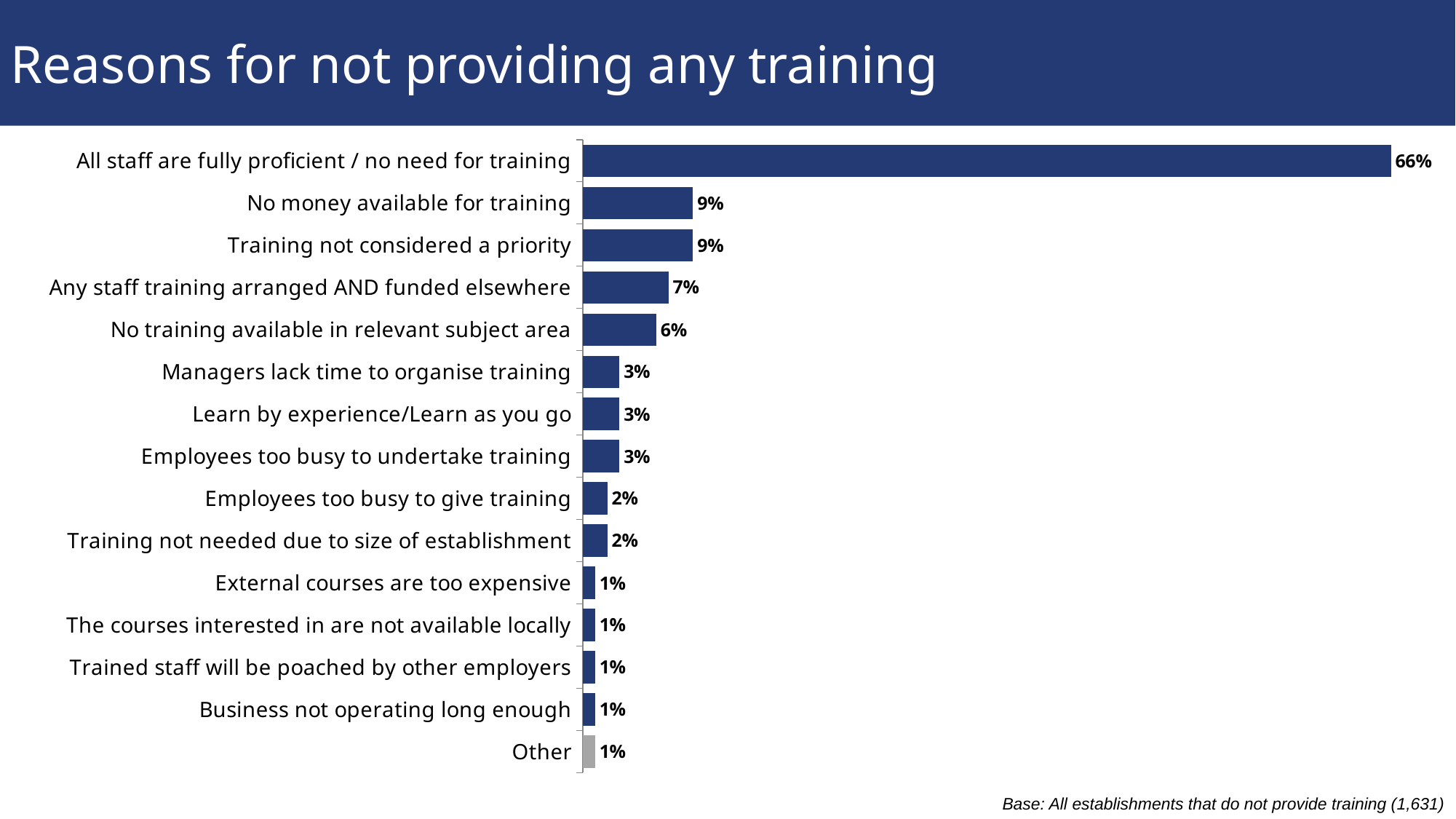
Which reason has the highest percentage? All staff are fully proficient / no need for training How many reasons (categories) are shown in the chart? 15 What is the value for 'Training not needed due to size of establishment'? 2% What percentage of establishments gave 'All staff are fully proficient / no need for training' as a reason for not providing training? 66% What type of chart is shown on the slide? Bar chart What is the title of the slide? Reasons for not providing any training What is the difference between 'All staff are fully proficient / no need for training' and 'No money available for training'? 57% What is the difference between 'Any staff training arranged AND funded elsewhere' and 'Managers lack time to organise training'? 4% What is the value for 'Any staff training arranged AND funded elsewhere'? 7% Which category's bar is coloured grey rather than dark blue? Other Which is larger: 'No training available in relevant subject area' or 'Employees too busy to give training'? No training available in relevant subject area What is the value for 'No training available in relevant subject area'? 6%